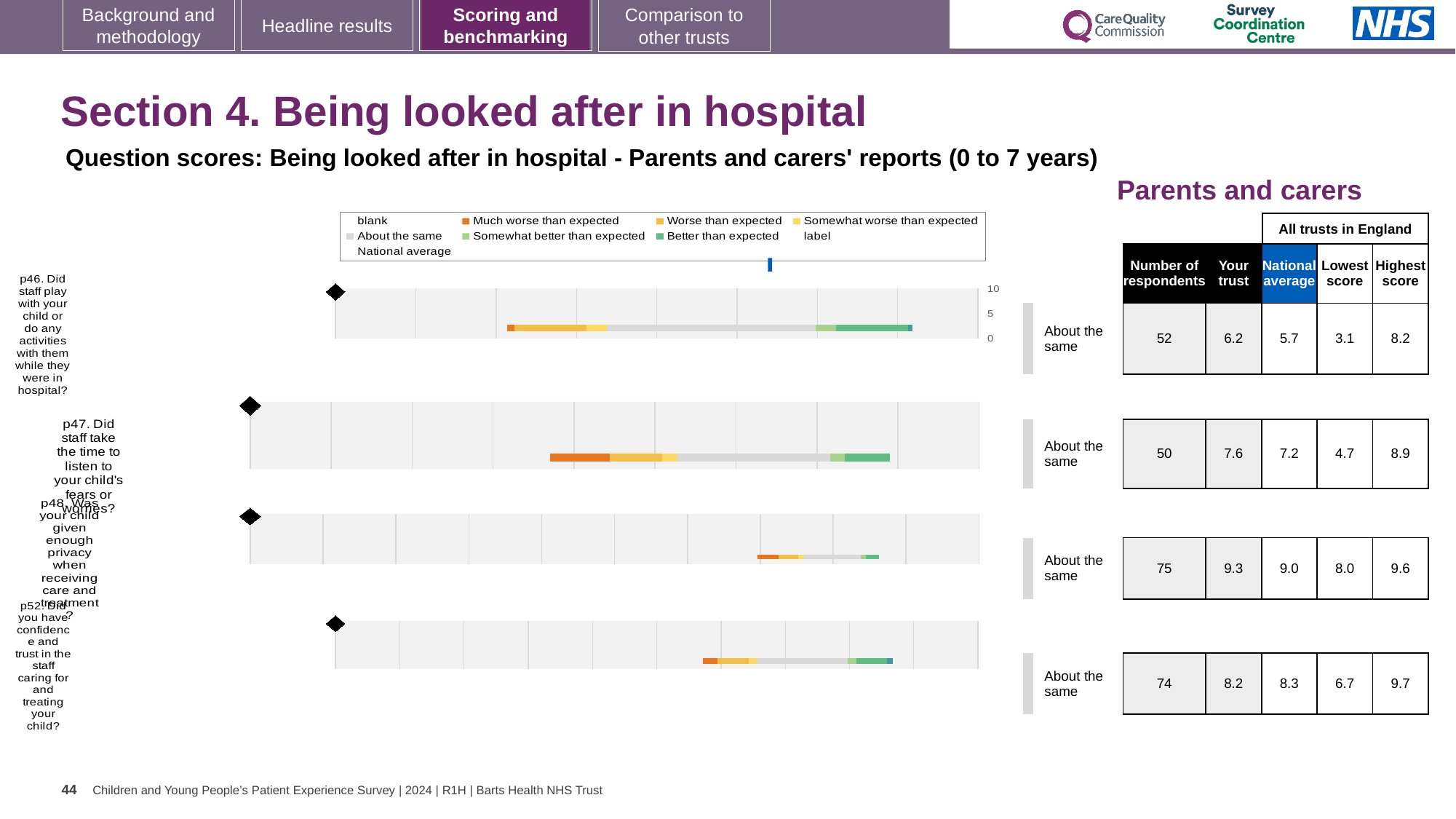
In the table beside the p46 chart, what is the 'Your trust' score? 6.2 Which question has the highest 'Your trust' score in the tables? p48 Which question has the lowest number of respondents in the tables? p47 For p48, what is the difference between the Highest score and the Lowest score? 1.6 In the legend, what colour represents 'Much worse than expected'? orange In the table beside the p52 chart, what is the Highest score? 9.7 In the table beside the p48 chart, what is the number of respondents? 75 In the table beside the p47 chart, what is the National average score? 7.2 For p47, which is larger: the 'Your trust' score or the National average? Your trust How many question charts are shown on the slide? 4 What kind of chart is used for each question on this slide? bar chart What is the highest tick value shown on the axis above the p46 chart? 10